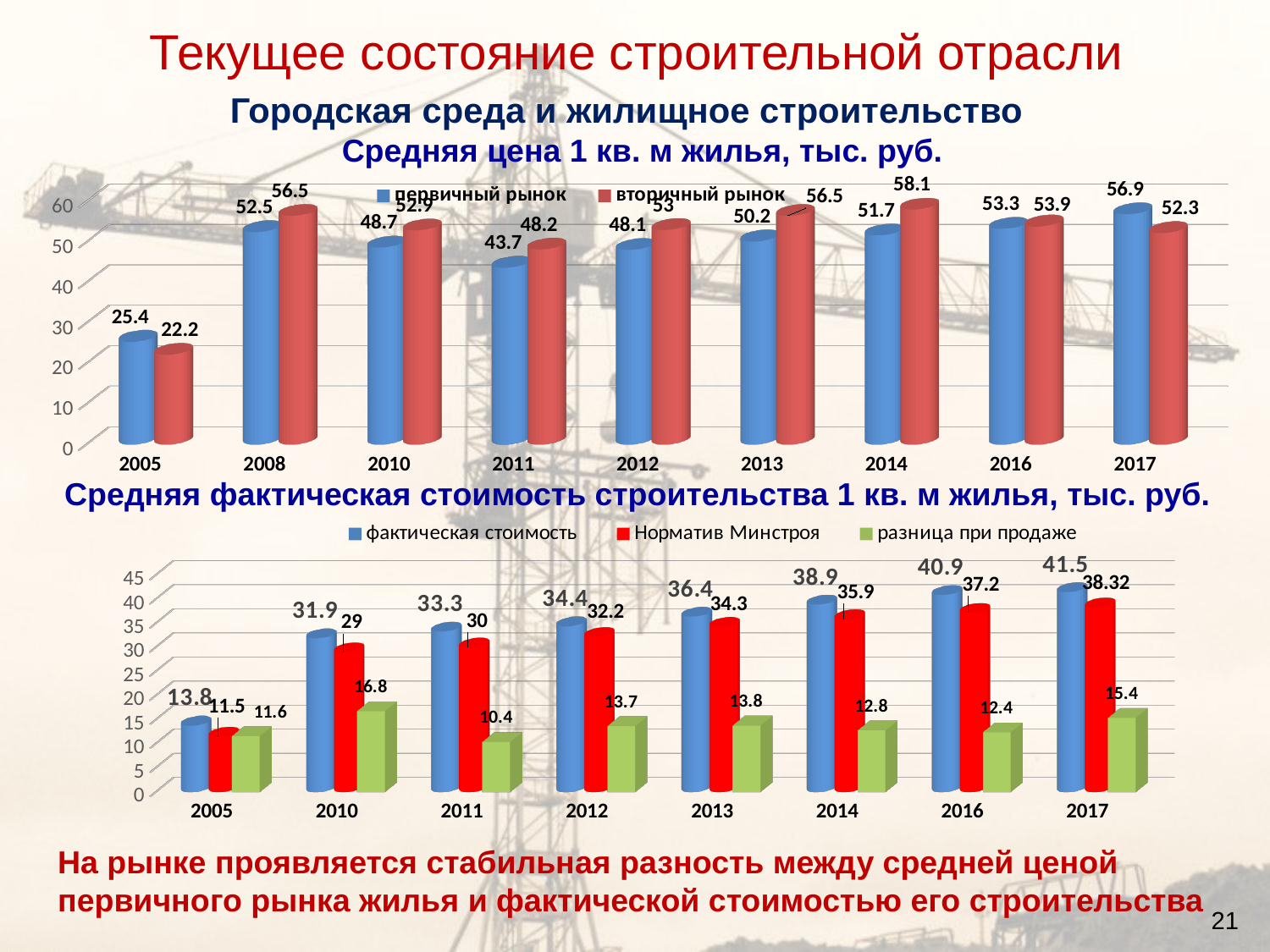
In the chart 'Средняя цена 1 кв. м жилья, тыс. руб.', what is the value for вторичный рынок in 2014? 58.1 In the chart 'Средняя фактическая стоимость строительства 1 кв. м жилья, тыс. руб.', does the фактическая стоимость series rise or fall from 2005 to 2017? rise In the chart 'Средняя фактическая стоимость строительства 1 кв. м жилья, тыс. руб.', how many series does the legend list? 3 In the chart 'Средняя фактическая стоимость строительства 1 кв. м жилья, тыс. руб.', what is the value for Норматив Минстроя in 2017? 38.32 In the chart 'Средняя цена 1 кв. м жилья, тыс. руб.', how many years are shown on the x axis? 9 In the chart 'Средняя цена 1 кв. м жилья, тыс. руб.', which year has the highest value for вторичный рынок? 2014 In the chart 'Средняя фактическая стоимость строительства 1 кв. м жилья, тыс. руб.', what is the value for разница при продаже in 2011? 10.4 In the chart 'Средняя цена 1 кв. м жилья, тыс. руб.', which year has the lowest value for первичный рынок? 2005 What kind of chart is the lower chart on the slide? bar chart In the chart 'Средняя цена 1 кв. м жилья, тыс. руб.', what is the value for первичный рынок in 2017? 56.9 In the chart 'Средняя фактическая стоимость строительства 1 кв. м жилья, тыс. руб.', which is larger in 2010: разница при продаже or Норматив Минстроя? Норматив Минстроя In the chart 'Средняя цена 1 кв. м жилья, тыс. руб.', what is the difference between вторичный рынок and первичный рынок in 2013? 6.3